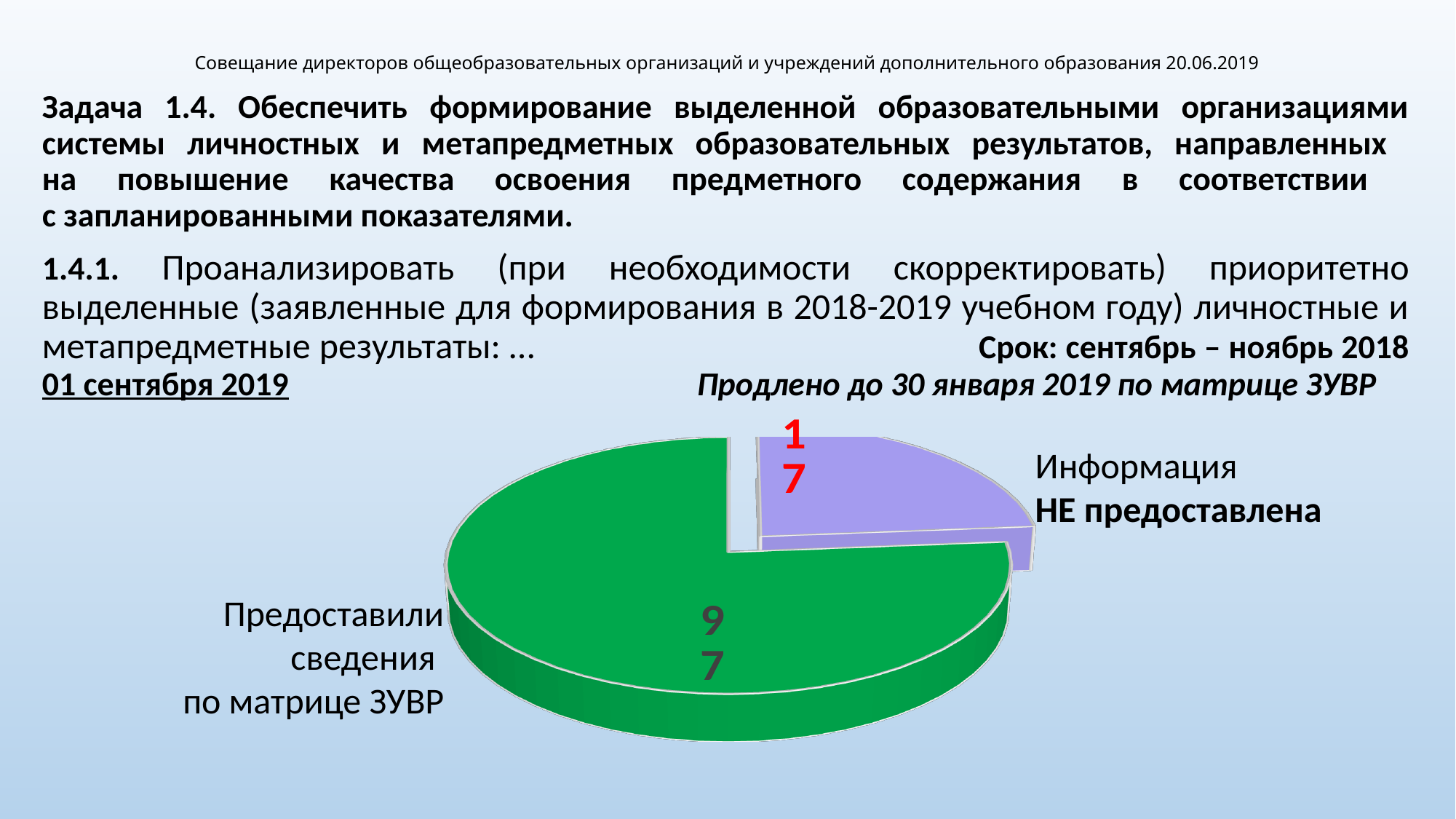
What is the total of the two values shown in the pie chart? 114 What is the value of the slice labelled "Информация НЕ предоставлена"? 17 What colour is the slice for "Предоставили сведения по матрице ЗУВР"? green How many slices does the pie chart have? 2 What colour is the slice for "Информация НЕ предоставлена"? purple What kind of chart is shown on the slide? pie chart What is the value of the slice labelled "Предоставили сведения по матрице ЗУВР"? 97 Which is larger: the value for "Предоставили сведения по матрице ЗУВР" or the value for "Информация НЕ предоставлена"? Предоставили сведения по матрице ЗУВР Which slice of the pie chart is the largest? Предоставили сведения по матрице ЗУВР What is the difference between the value for "Предоставили сведения по матрице ЗУВР" and the value for "Информация НЕ предоставлена"? 80 Which slice of the pie chart is the smallest? Информация НЕ предоставлена